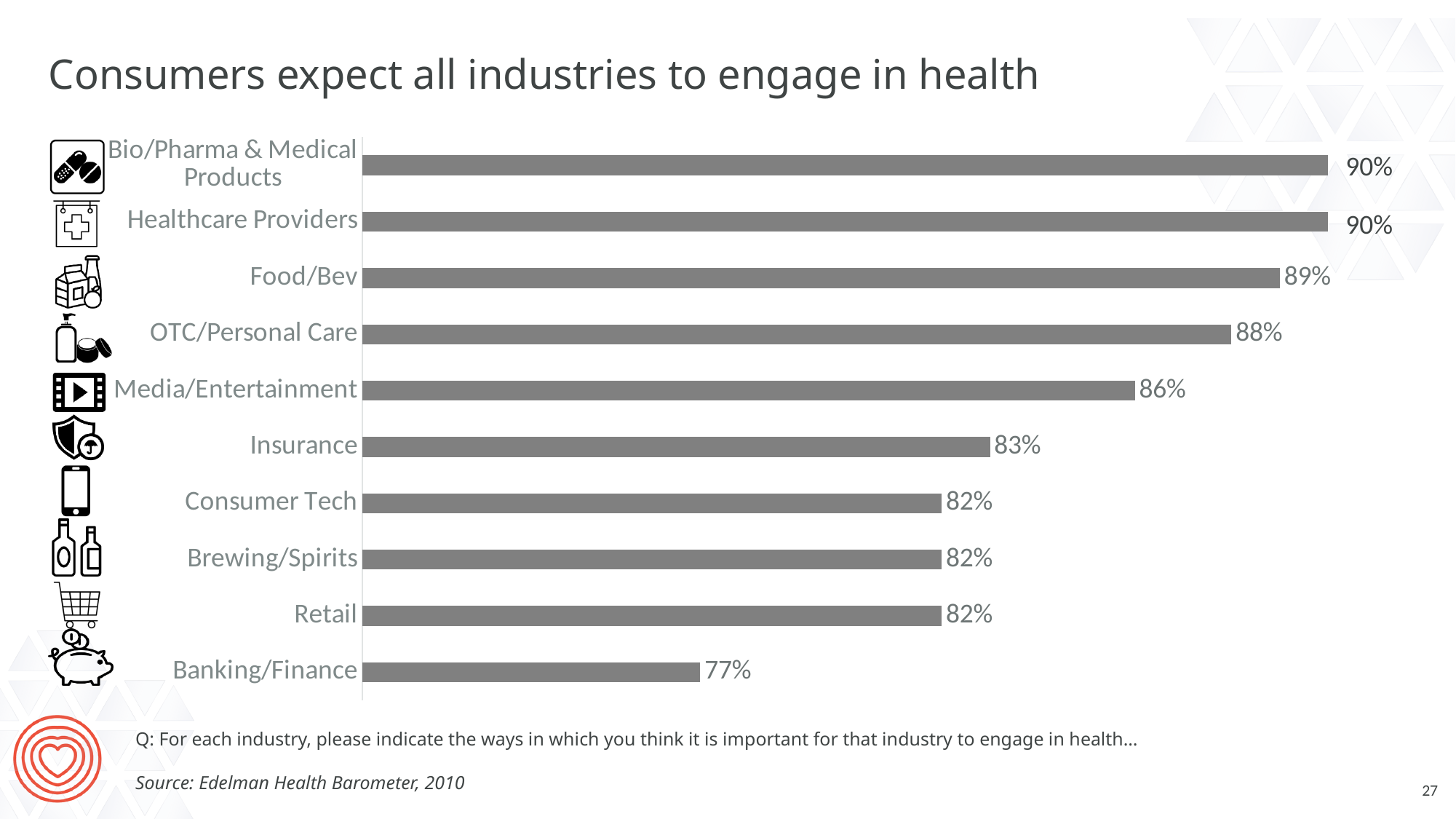
Which category has the lowest value? Banking/Finance What is the difference between the values for OTC/Personal Care and Banking/Finance? 11% What is the value for Media/Entertainment? 86% Which is larger, the value for Banking/Finance or the value for Retail? Retail How many categories are shown in the chart? 10 What kind of chart is shown on the slide? Bar chart What is the value for Food/Bev? 89% Which is larger, the value for Food/Bev or the value for Consumer Tech? Food/Bev What is the difference between the values for Healthcare Providers and Insurance? 7% What is the value for Banking/Finance? 77% What is the value for Insurance? 83% What is the title of the slide? Consumers expect all industries to engage in health